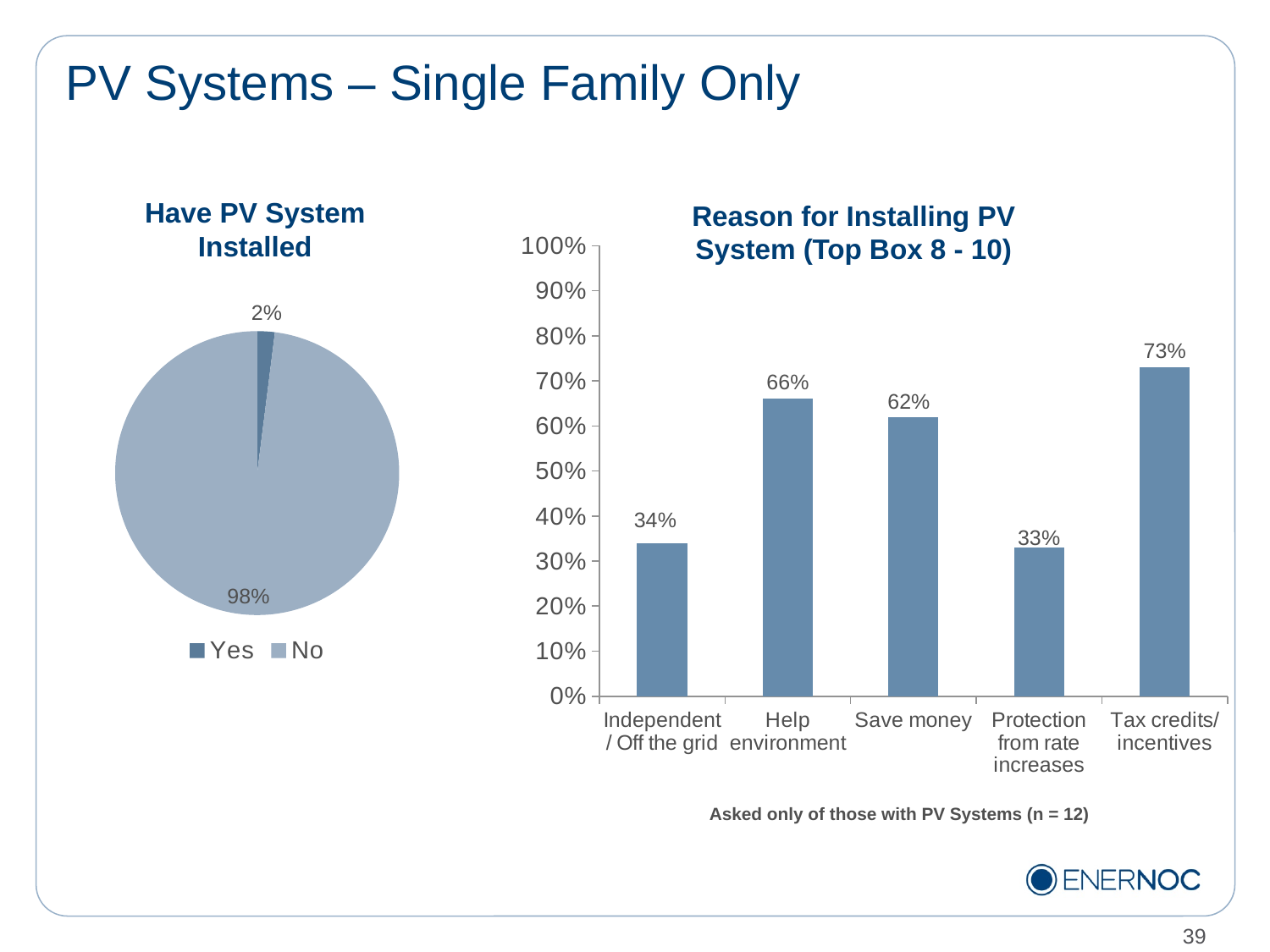
In the 'Have PV System Installed' chart, what percentage answered Yes? 2% In the 'Reason for Installing PV System' chart, what is the value for Tax credits/ incentives? 73% In the 'Reason for Installing PV System' chart, which is larger: Independent / Off the grid or Save money? Save money In the 'Reason for Installing PV System' chart, what is the difference between Help environment and Save money? 4% In the 'Reason for Installing PV System' chart, which reason has the highest value? Tax credits/ incentives In the 'Reason for Installing PV System' chart, what is the value for Help environment? 66% What kind of chart is 'Have PV System Installed'? Pie chart What kind of chart is 'Reason for Installing PV System (Top Box 8 - 10)'? Bar chart How many reasons are shown in the 'Reason for Installing PV System' chart? 5 In the 'Have PV System Installed' chart, what percentage answered No? 98% In the 'Reason for Installing PV System' chart, which reason has the lowest value? Protection from rate increases How many entries does the legend of the 'Have PV System Installed' chart list? 2